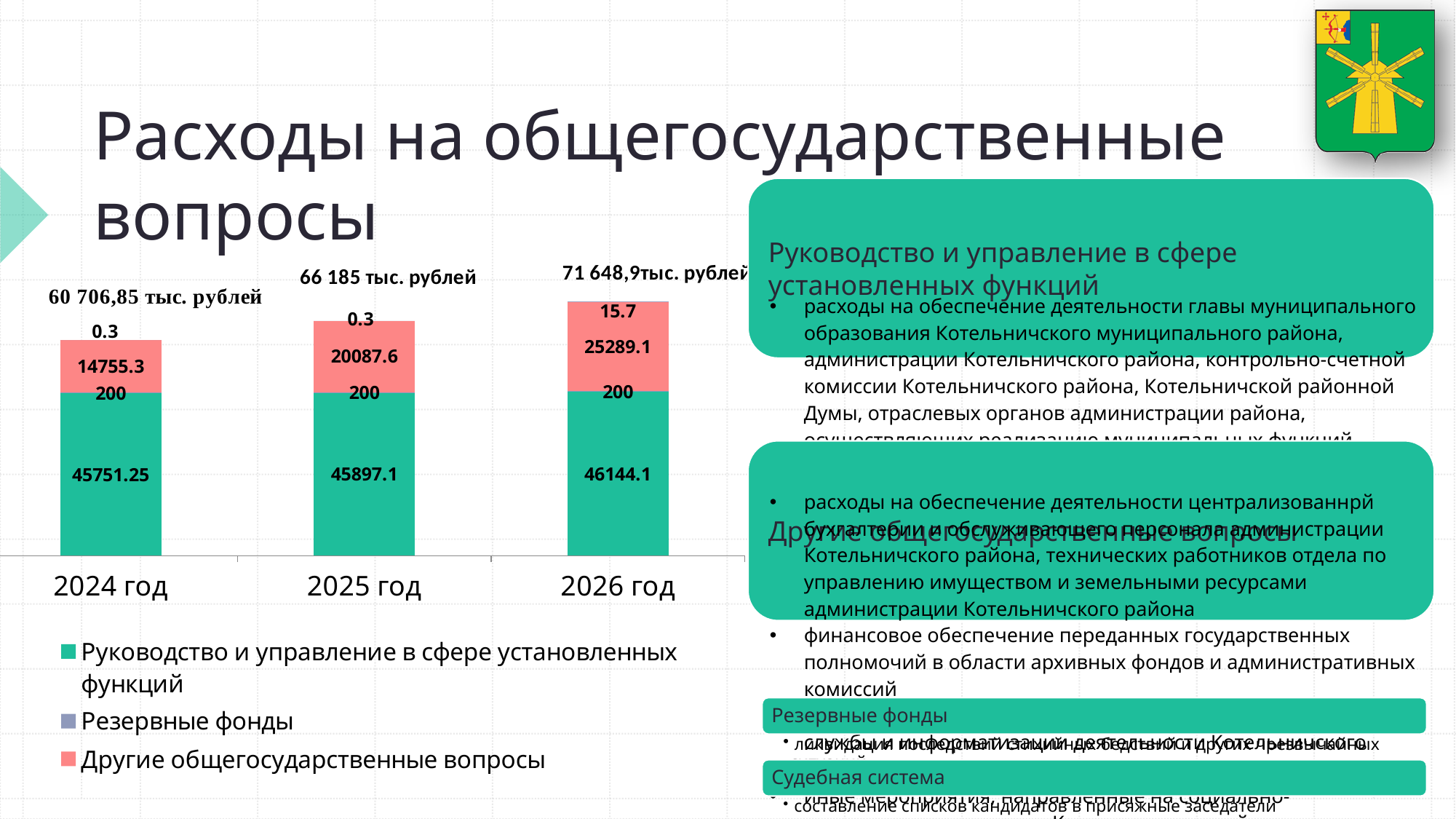
How many series does the legend list? 3 What is the difference between the 'Другие общегосударственные вопросы' values for 2026 год and 2024 год? 10533.8 What total is printed above the bar for 2026 год? 71 648,9тыс. рублей Which year has the lowest total expenditure? 2024 год Which year has the highest total expenditure? 2026 год What total is printed above the bar for 2025 год? 66 185 тыс. рублей Do the total expenditures rise or fall from 2024 год to 2026 год? rise What is the value of the 'Другие общегосударственные вопросы' segment for 2025 год? 20087.6 Which is larger: the 'Руководство и управление в сфере установленных функций' value for 2026 год or for 2024 год? 2026 год How many years (categories) are shown on the x axis? 3 What is the value of the 'Другие общегосударственные вопросы' segment for 2026 год? 25289.1 What is the value of the 'Руководство и управление в сфере установленных функций' segment for 2024 год? 45751.25